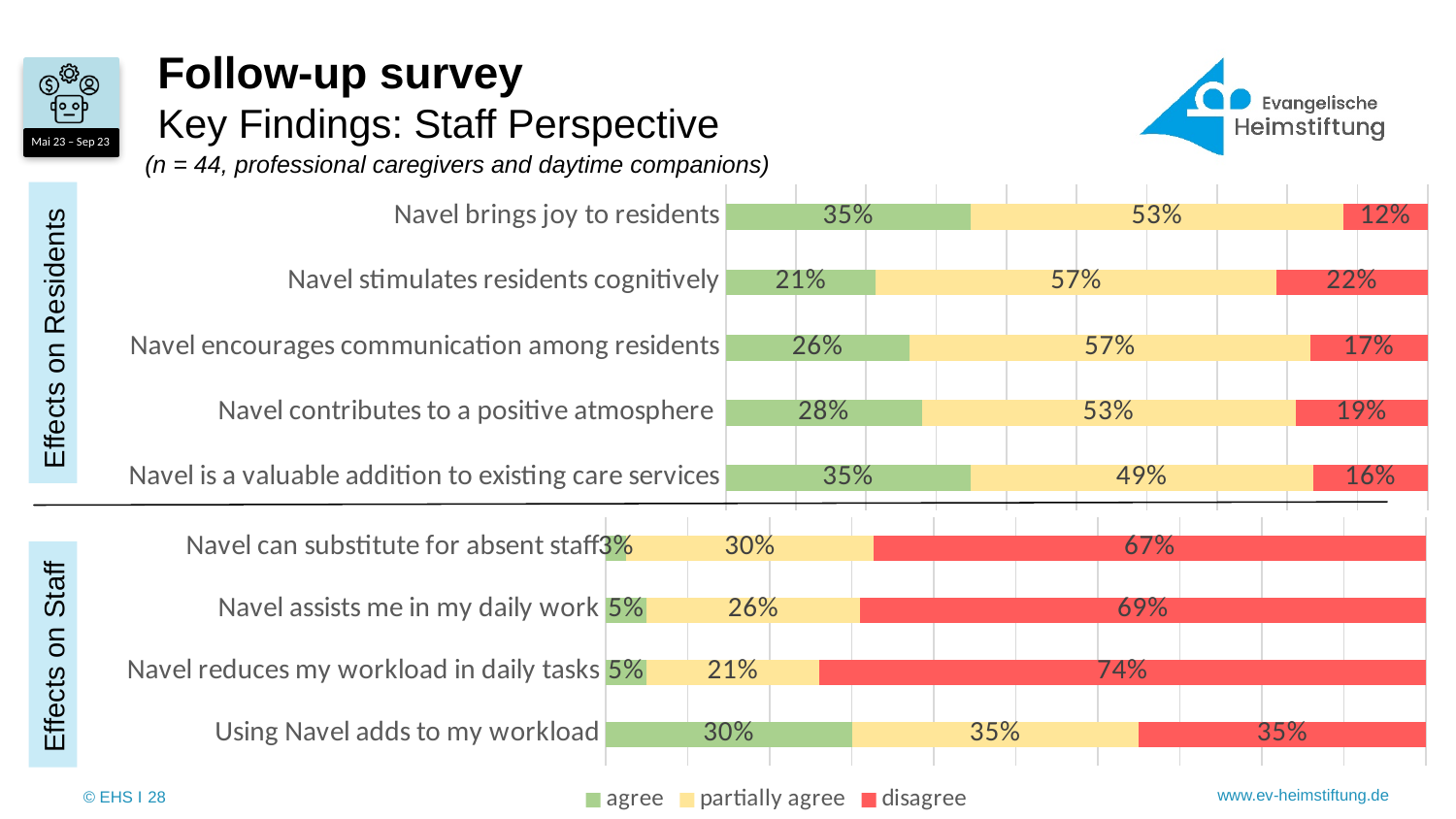
In the 'Effects on Staff' chart, what is the 'partially agree' value for 'Navel can substitute for absent staff'? 30% In the 'Effects on Staff' chart, which is larger: the 'disagree' value for 'Navel assists me in my daily work' or for 'Navel can substitute for absent staff'? Navel assists me in my daily work In the 'Effects on Residents' chart, what is the 'disagree' value for 'Navel stimulates residents cognitively'? 22% In the 'Effects on Staff' chart, which statement has the lowest 'agree' value? Navel can substitute for absent staff How many statements are shown in the 'Effects on Staff' chart? 4 In the 'Effects on Residents' chart, which statement has the highest 'disagree' value? Navel stimulates residents cognitively In the 'Effects on Residents' chart, what percentage of staff agree that Navel brings joy to residents? 35% How many series does the legend list? 3 What kind of chart is used on this slide? Stacked bar chart How many statements are shown in the 'Effects on Residents' chart? 5 In the 'Effects on Residents' chart, what is the difference between the 'partially agree' values for 'Navel stimulates residents cognitively' and 'Navel is a valuable addition to existing care services'? 8% In the 'Effects on Staff' chart, what percentage disagree that Navel reduces my workload in daily tasks? 74%